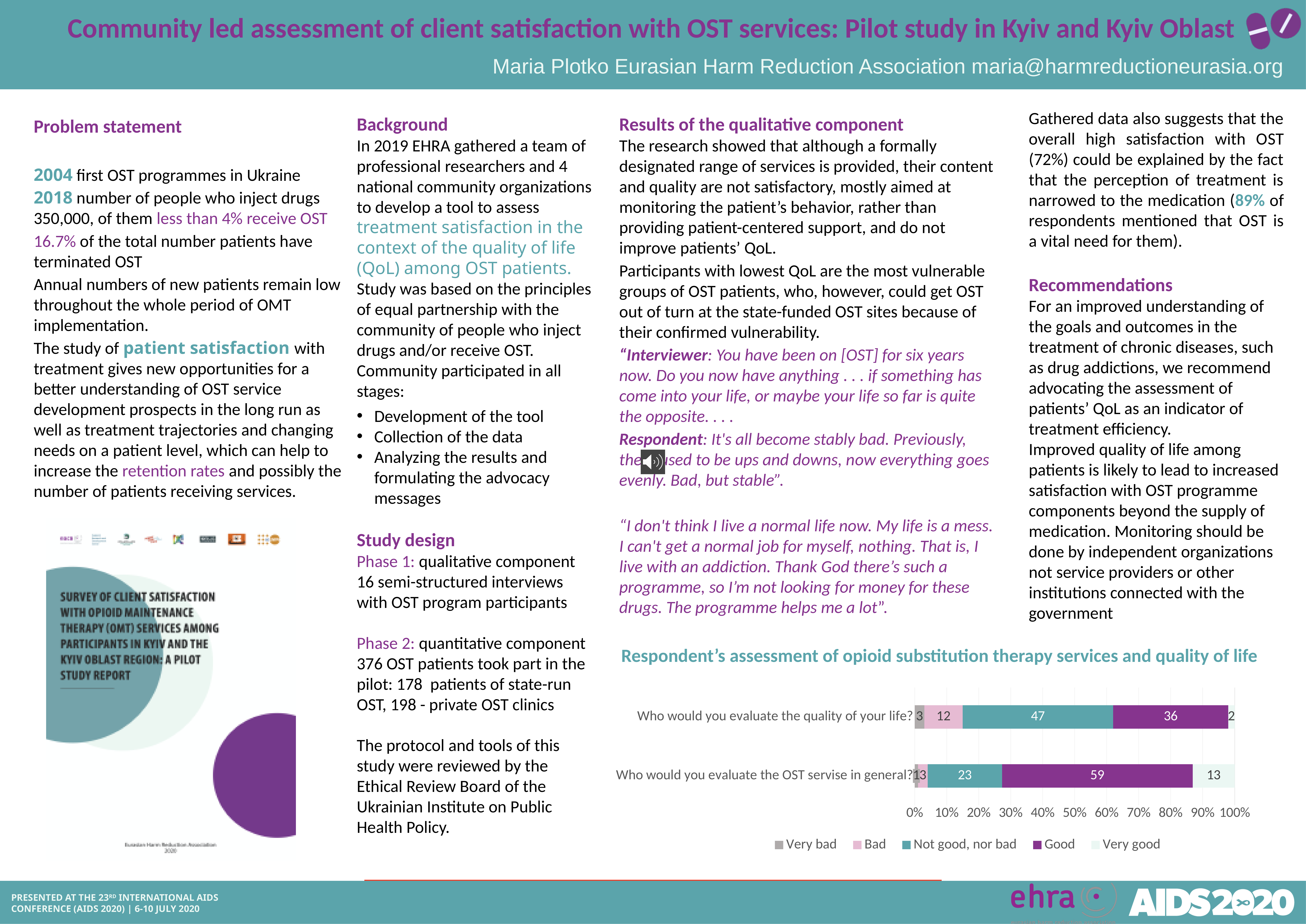
What percentage of respondents rated the quality of their life as "Bad"? 12 How many series does the legend of the chart list? 5 What is the difference between the "Good" share for the OST service in general and the "Good" share for quality of life? 23 What type of chart is shown under the title "Respondent's assessment of opioid substitution therapy services and quality of life"? Stacked bar chart Which rating has the largest share for the question "Who would you evaluate the OST servise in general?"? Good Which is larger: the "Not good, nor bad" share for quality of life or for the OST service in general? Quality of life What percentage of respondents rated the OST service in general as "Very good"? 13 What percentage of respondents rated the quality of their life as "Not good, nor bad"? 47 What percentage of respondents rated the OST service in general as "Good"? 59 What percentage of respondents rated the quality of their life as "Good"? 36 How many questions (categories) are plotted in the chart? 2 Which rating has the largest share for the question "Who would you evaluate the quality of your life?"? Not good, nor bad